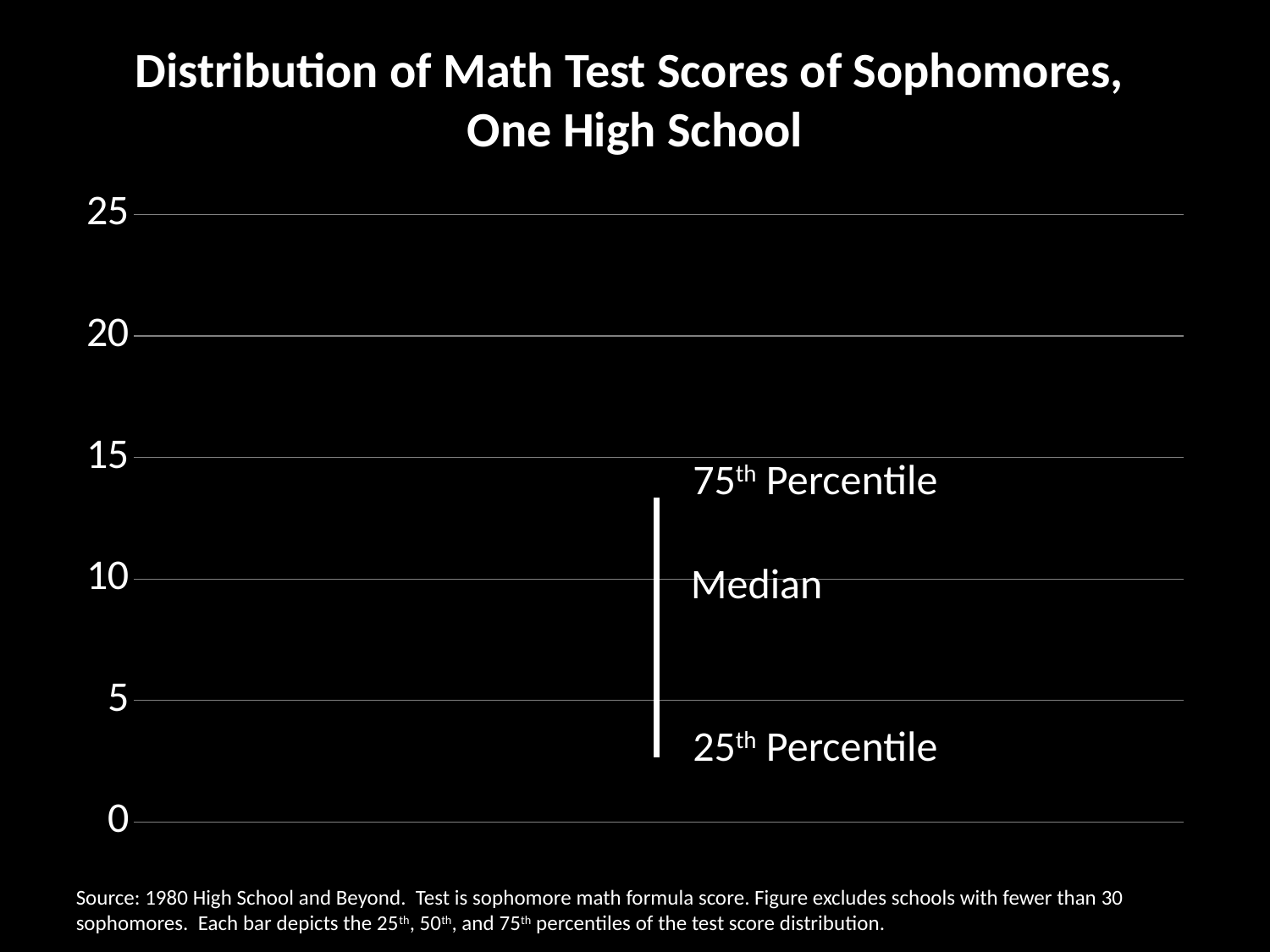
Is the value for the 25th Percentile greater or less than 0? greater Is the value for the 25th Percentile greater or less than 5? less What kind of chart is shown on the slide? bar chart What is the highest value shown on the vertical axis? 25 Is the Median greater or less than 15? less How many bars are plotted on the chart? 1 What is the title of the chart? Distribution of Math Test Scores of Sophomores, One High School Which is larger, the 75th Percentile or the 25th Percentile? 75th Percentile